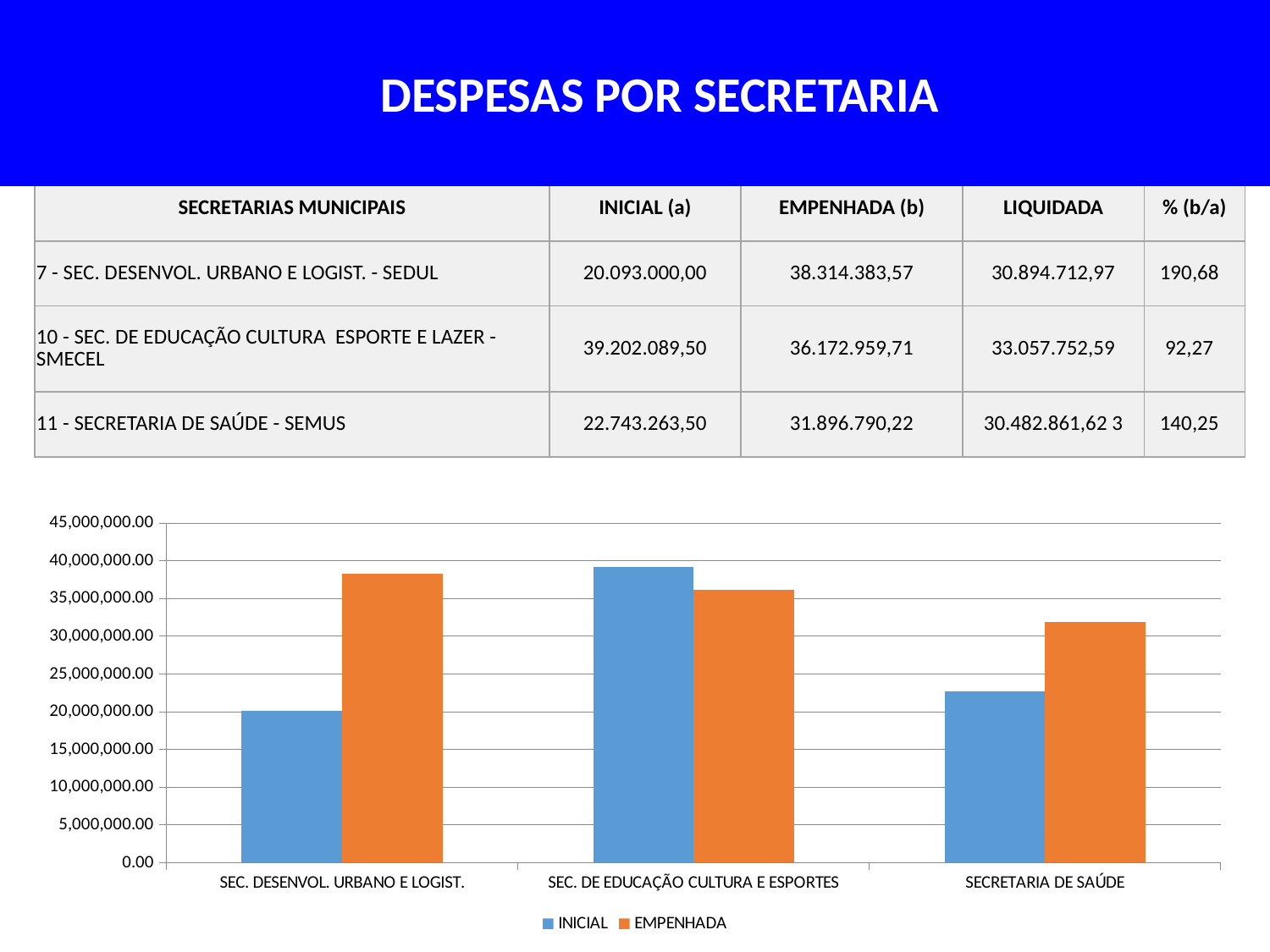
Which category has the highest EMPENHADA bar? SEC. DESENVOL. URBANO E LOGIST. How many series does the chart legend list? 2 Is the EMPENHADA value for SEC. DESENVOL. URBANO E LOGIST. greater or less than 35,000,000.00? greater For SEC. DE EDUCAÇÃO CULTURA E ESPORTES, which is larger, INICIAL or EMPENHADA? INICIAL Is the INICIAL value for SECRETARIA DE SAÚDE greater or less than 25,000,000.00? less What kind of chart is shown on the slide? bar chart Which colour represents the EMPENHADA series in the chart? orange Which category has the lowest EMPENHADA bar? SECRETARIA DE SAÚDE Which category has the highest INICIAL bar? SEC. DE EDUCAÇÃO CULTURA E ESPORTES Which category has the lowest INICIAL bar? SEC. DESENVOL. URBANO E LOGIST. How many categories are shown on the x axis of the chart? 3 For SEC. DESENVOL. URBANO E LOGIST., which is larger, INICIAL or EMPENHADA? EMPENHADA